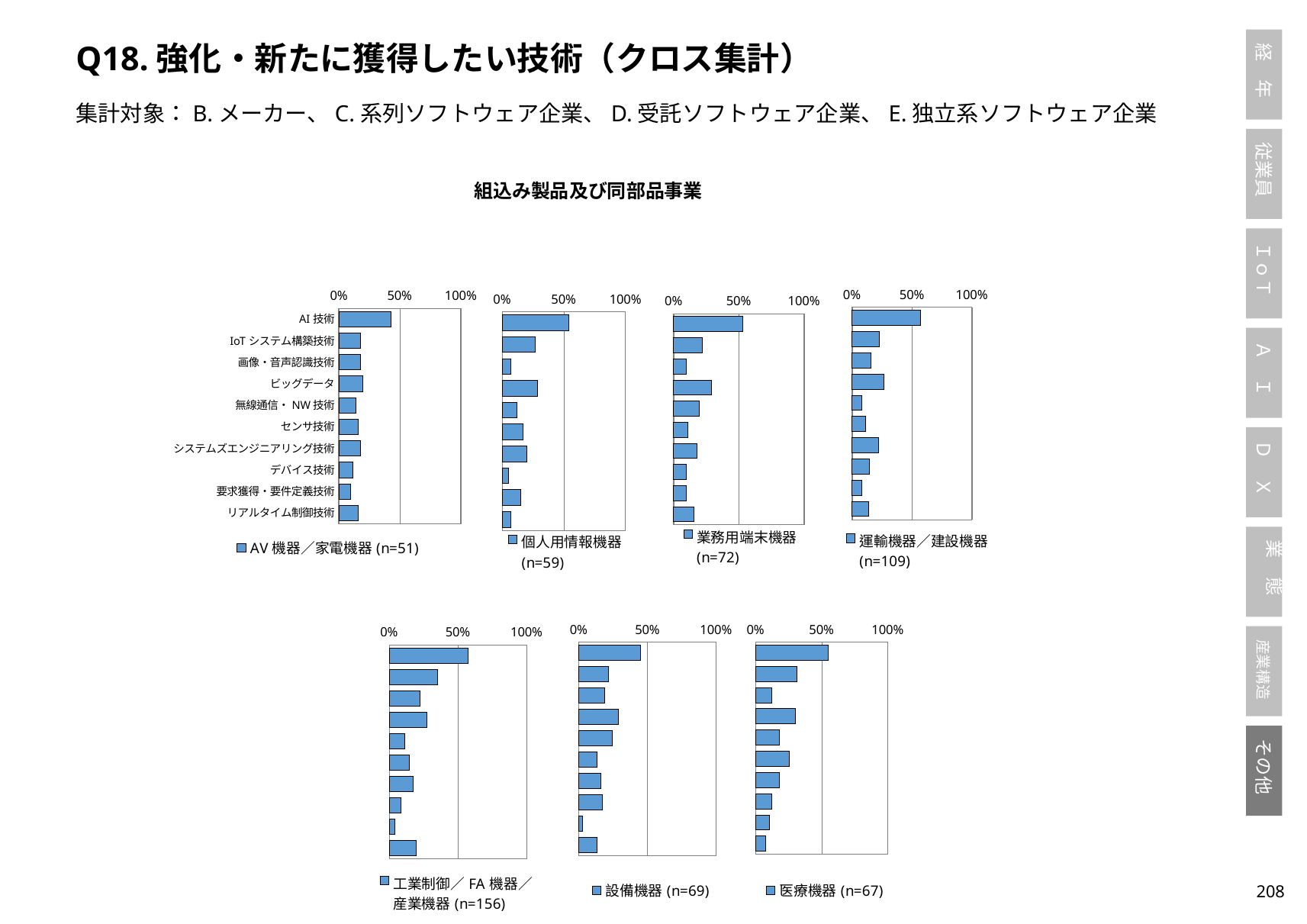
How many technology categories are listed on the AV 機器／家電機器 (n=51) chart? 10 In the 設備機器 (n=69) chart, which technology has the lowest value? 要求獲得・要件定義技術 In the AV 機器／家電機器 (n=51) chart, which technology has the highest value? AI 技術 In the AV 機器／家電機器 (n=51) chart, is the value for AI 技術 greater or less than 50%? less In the 工業制御／FA 機器／産業機器 (n=156) chart, which is larger: IoT システム構築技術 or 要求獲得・要件定義技術? IoT システム構築技術 How many separate bar charts are shown on the slide? 7 In the 工業制御／FA 機器／産業機器 (n=156) chart, is the value for the first category (AI 技術) greater or less than 50%? greater In the 業務用端末機器 (n=72) chart, which technology has the highest value? AI 技術 What kind of chart is used for the AV 機器／家電機器 (n=51) data? bar chart What is the common title shown above the group of charts? 組込み製品及び同部品事業 What is the sample size (n) shown in the legend of the 運輸機器／建設機器 chart? n=109 How many series does the legend of the 設備機器 (n=69) chart list? 1